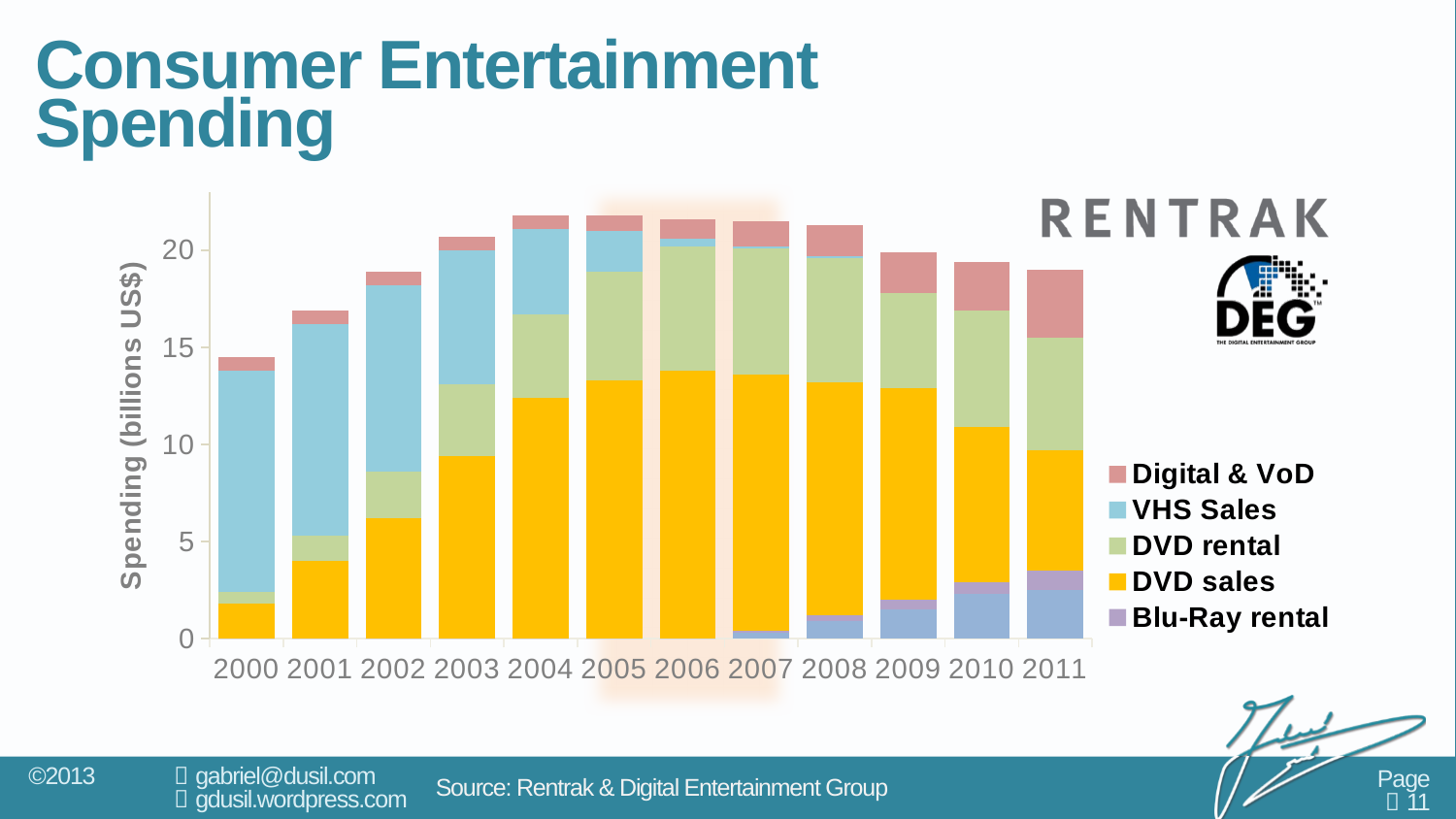
Which year has the lowest total consumer entertainment spending? 2000 Which year has higher total spending, 2000 or 2005? 2005 Is the total spending for 2011 greater or less than 20? less Is the DVD sales value for 2006 greater or less than 10? greater What is the label on the y axis of the chart? Spending (billions US$) Is the total spending for 2005 greater or less than 20? greater What kind of chart is shown on the slide? Stacked bar chart Do total spending values rise or fall from 2007 to 2011? fall Which series is listed last in the chart's legend? Blu-Ray rental How many years are shown along the x axis of the chart? 12 How many series does the chart's legend list? 5